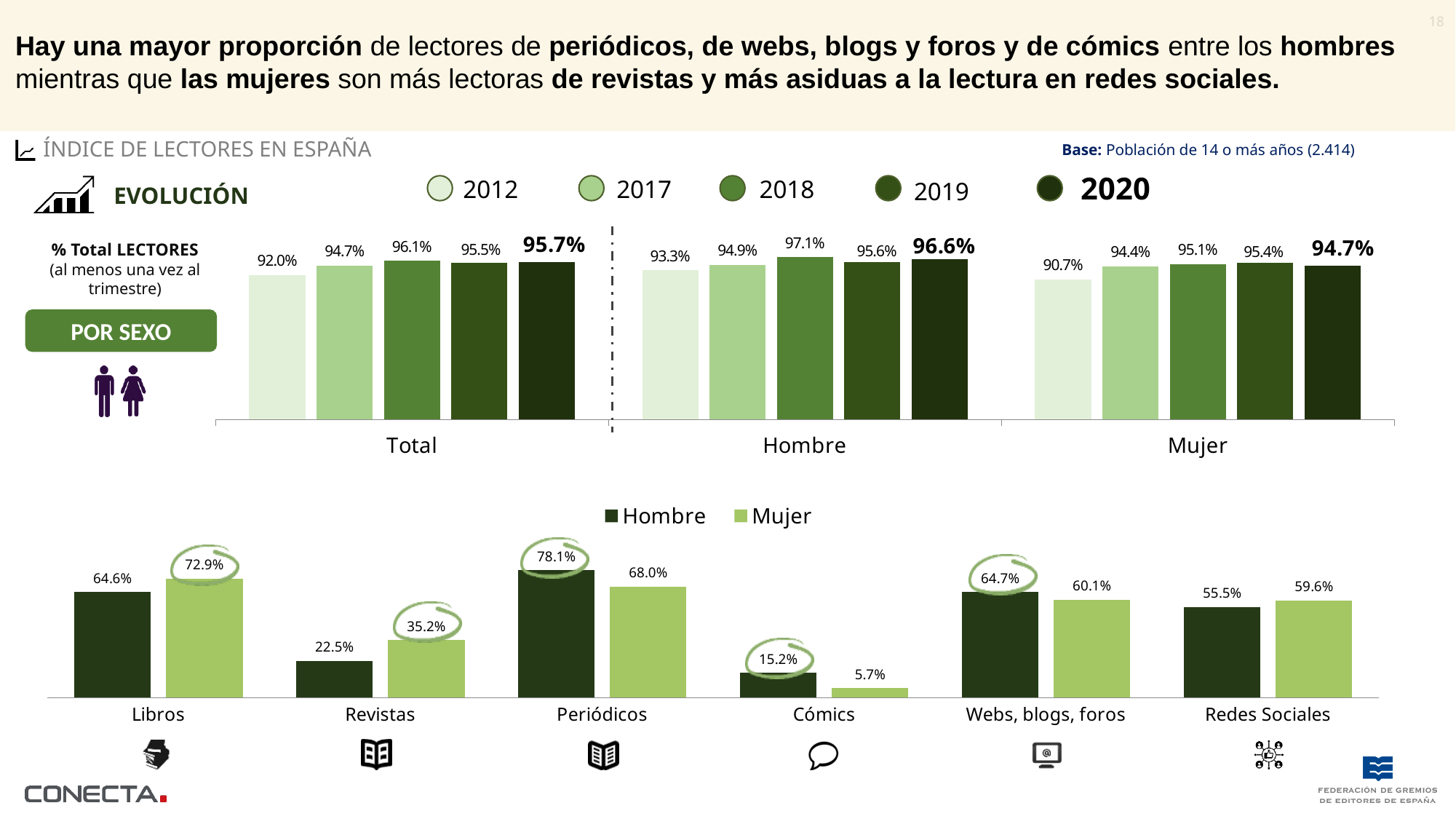
In the top evolution chart, what is the value for Total in 2020? 95.7% In the bottom chart by reading type, which is larger for Libros, Hombre or Mujer? Mujer In the bottom chart by reading type, what is the Hombre value for Periódicos? 78.1% In the top evolution chart, what is the value for Mujer in 2012? 90.7% What kind of chart is the bottom chart by reading type? Bar chart In the top evolution chart, what is the difference between the Hombre and Mujer values for 2020? 1.9% In the top evolution chart, how many years does the legend list? 5 In the top evolution chart, which year has the highest value for Hombre? 2018 In the bottom chart by reading type, what is the difference between the Hombre and Mujer values for Cómics? 9.5% In the bottom chart by reading type, which category has the lowest Mujer value? Cómics In the bottom chart by reading type, what is the Mujer value for Revistas? 35.2% In the bottom chart by reading type, how many categories are shown on the x axis? 6